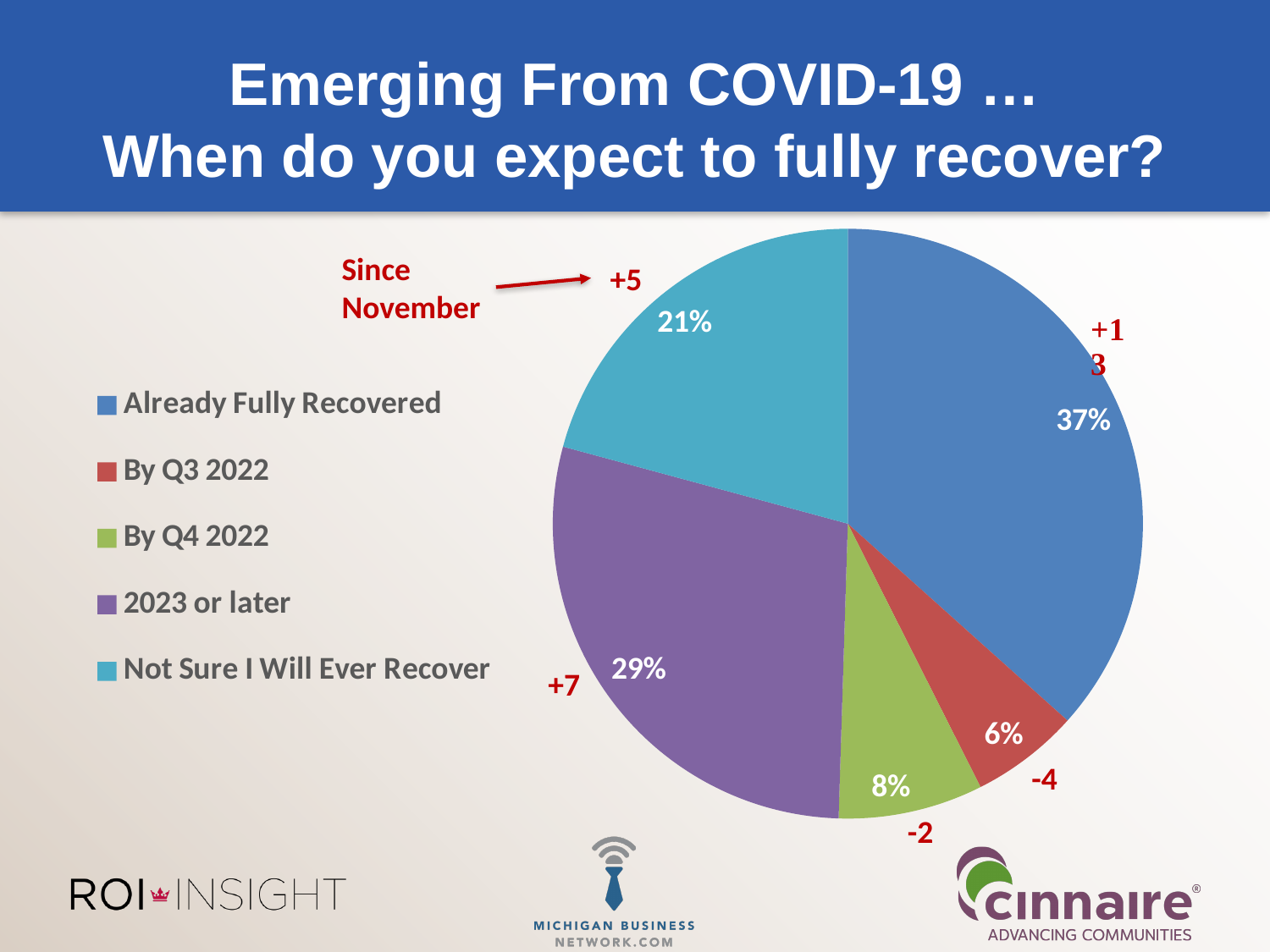
What share of respondents expect to recover in 2023 or later? 29% What colour is the slice for 2023 or later? purple What kind of chart is shown on the slide? pie chart What percentage of respondents expect to recover By Q4 2022? 8% What percentage of respondents are Not Sure I Will Ever Recover? 21% What percentage of respondents expect to recover By Q3 2022? 6% What is the difference in percentage points between Already Fully Recovered and 2023 or later? 8 Which is larger, the share for Not Sure I Will Ever Recover or the share for By Q4 2022? Not Sure I Will Ever Recover How many categories does the legend list? 5 Which category has the smallest slice of the pie? By Q3 2022 Which category has the largest slice of the pie? Already Fully Recovered What share of respondents said they have Already Fully Recovered? 37%